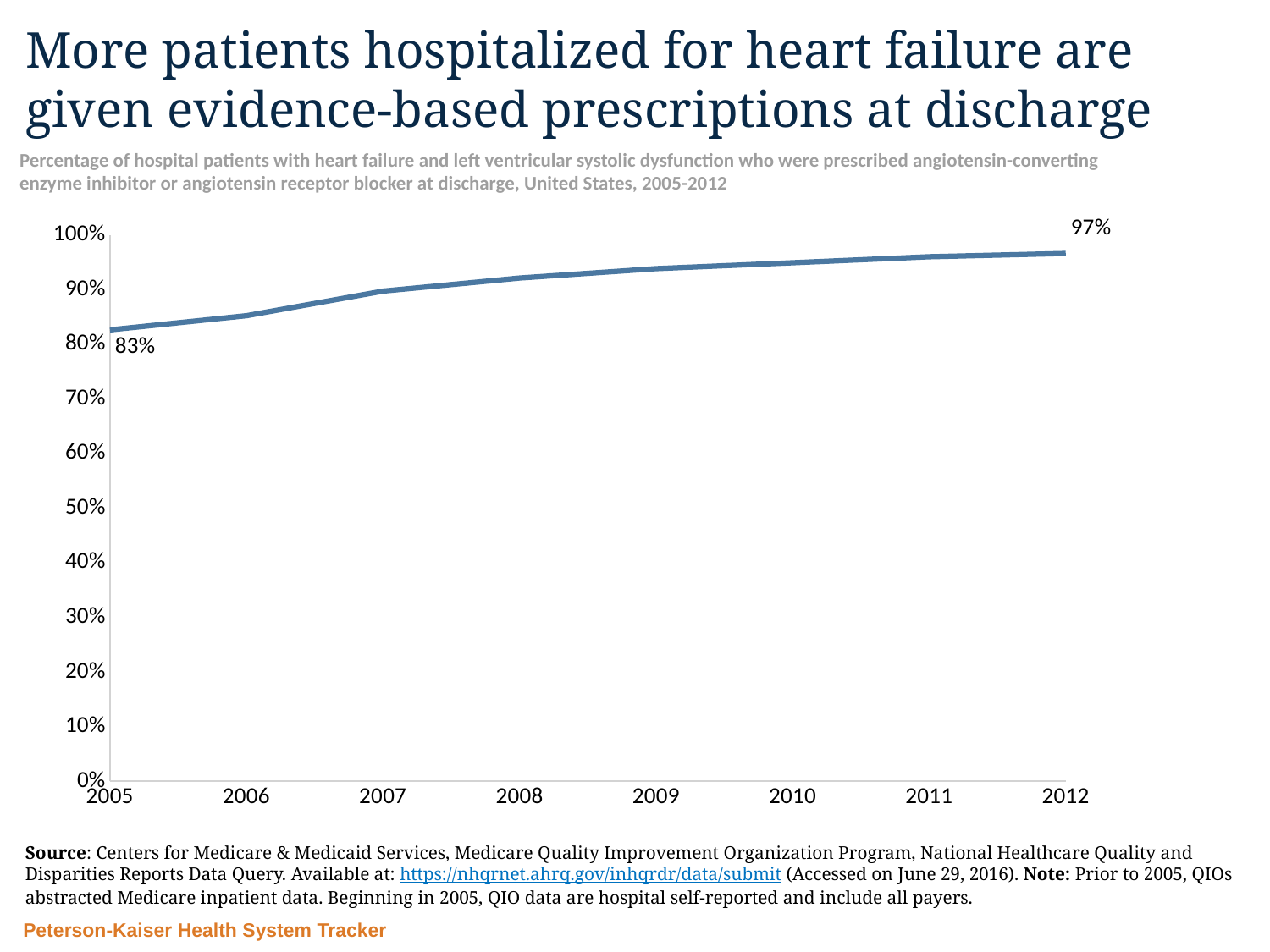
Do the values rise or fall from 2005 to 2012? rise Which is larger, the value for 2007 or the value for 2010? 2010 What kind of chart is this? line chart What is the title of the slide? More patients hospitalized for heart failure are given evidence-based prescriptions at discharge Is the value for 2006 greater or less than 90%? less What is the value for 2005? 83% Which year has the lowest value? 2005 Is the value for 2008 greater or less than 90%? greater Which year has the highest value? 2012 How many years are shown on the x axis? 8 What is the value for 2012? 97% What is the difference between the 2012 value and the 2005 value? 14 percentage points